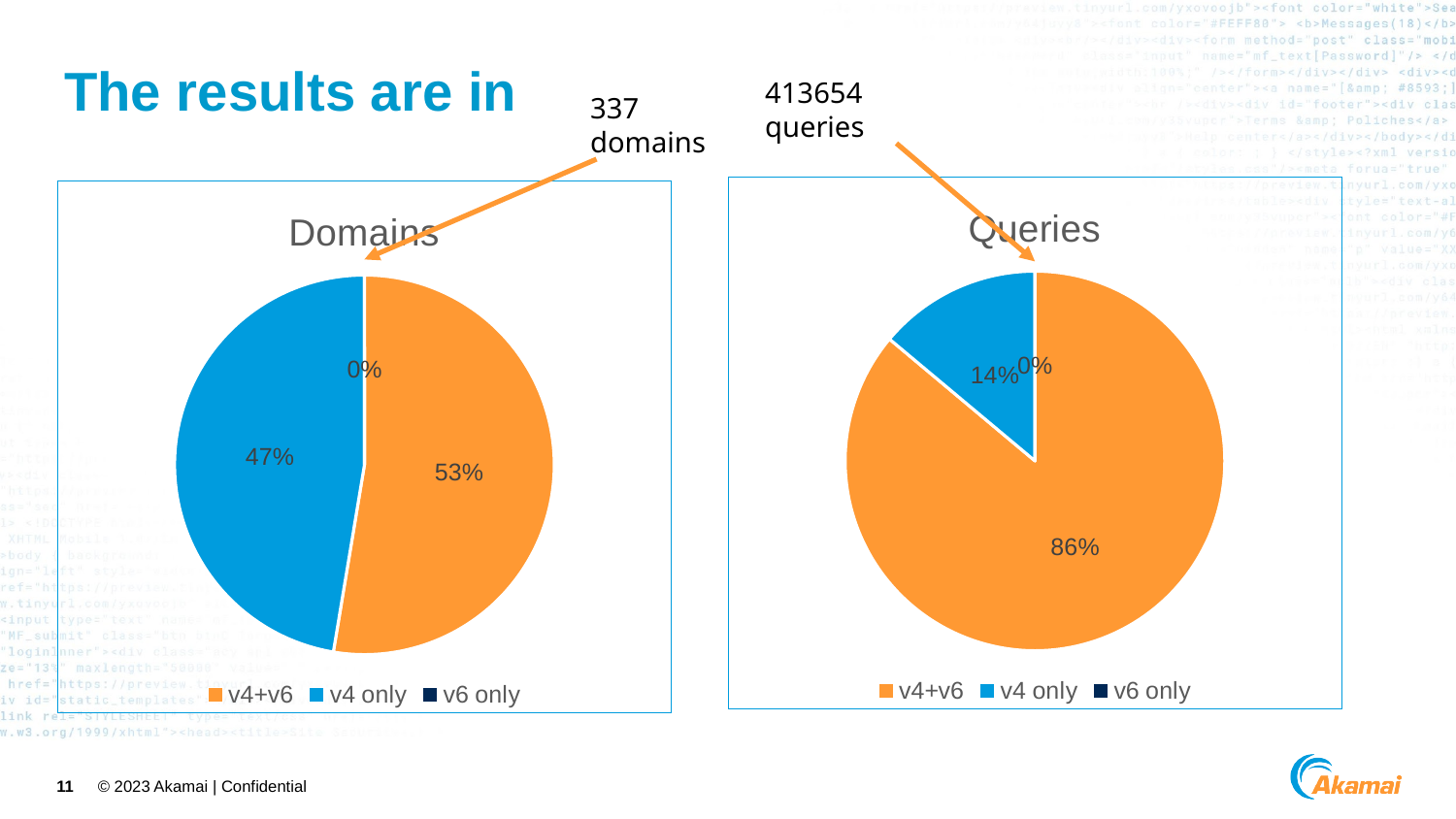
What kind of chart is the Queries chart? pie chart How many series does the legend of the Domains chart list? 3 In the Domains chart, which category has the smallest slice? v6 only In the Queries chart, what share of the pie is v4+v6? 86% In the Domains chart, what share of the pie is v4 only? 47% In the Queries chart, what is the difference between the v4+v6 share and the v4 only share? 72% In the Queries chart, what share of the pie is v6 only? 0% In the Queries chart, what share of the pie is v4 only? 14% In the Domains chart, what share of the pie is v4+v6? 53% In the Domains chart, which is larger, v4+v6 or v4 only? v4+v6 In the Queries chart, which category has the largest slice? v4+v6